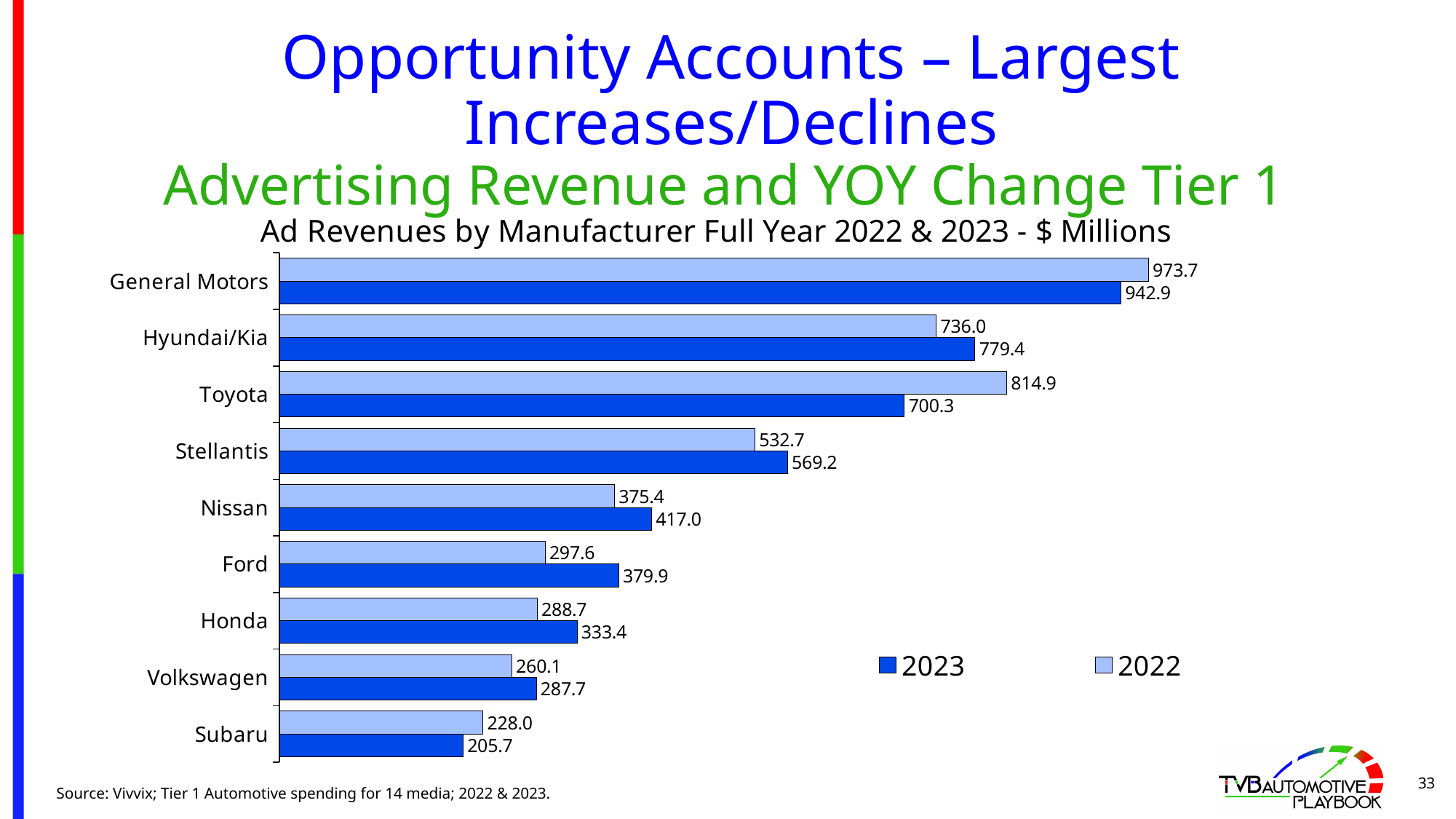
What is the difference between Nissan's 2023 and 2022 ad revenue, in $ millions? 41.6 What was Ford's ad revenue in 2023, in $ millions? 379.9 Which manufacturer had the lowest ad revenue in 2022? Subaru What was General Motors' ad revenue in 2023, in $ millions? 942.9 How many series does the legend list? 2 What type of chart is shown on the slide? Bar chart What was Toyota's ad revenue in 2022, in $ millions? 814.9 What is the difference between Toyota's 2022 and 2023 ad revenue, in $ millions? 114.6 How many manufacturers are shown in the chart? 9 Which was larger for Subaru: the 2022 value or the 2023 value? 2022 Which was larger for Hyundai/Kia: the 2022 value or the 2023 value? 2023 Which manufacturer had the highest ad revenue in 2023? General Motors